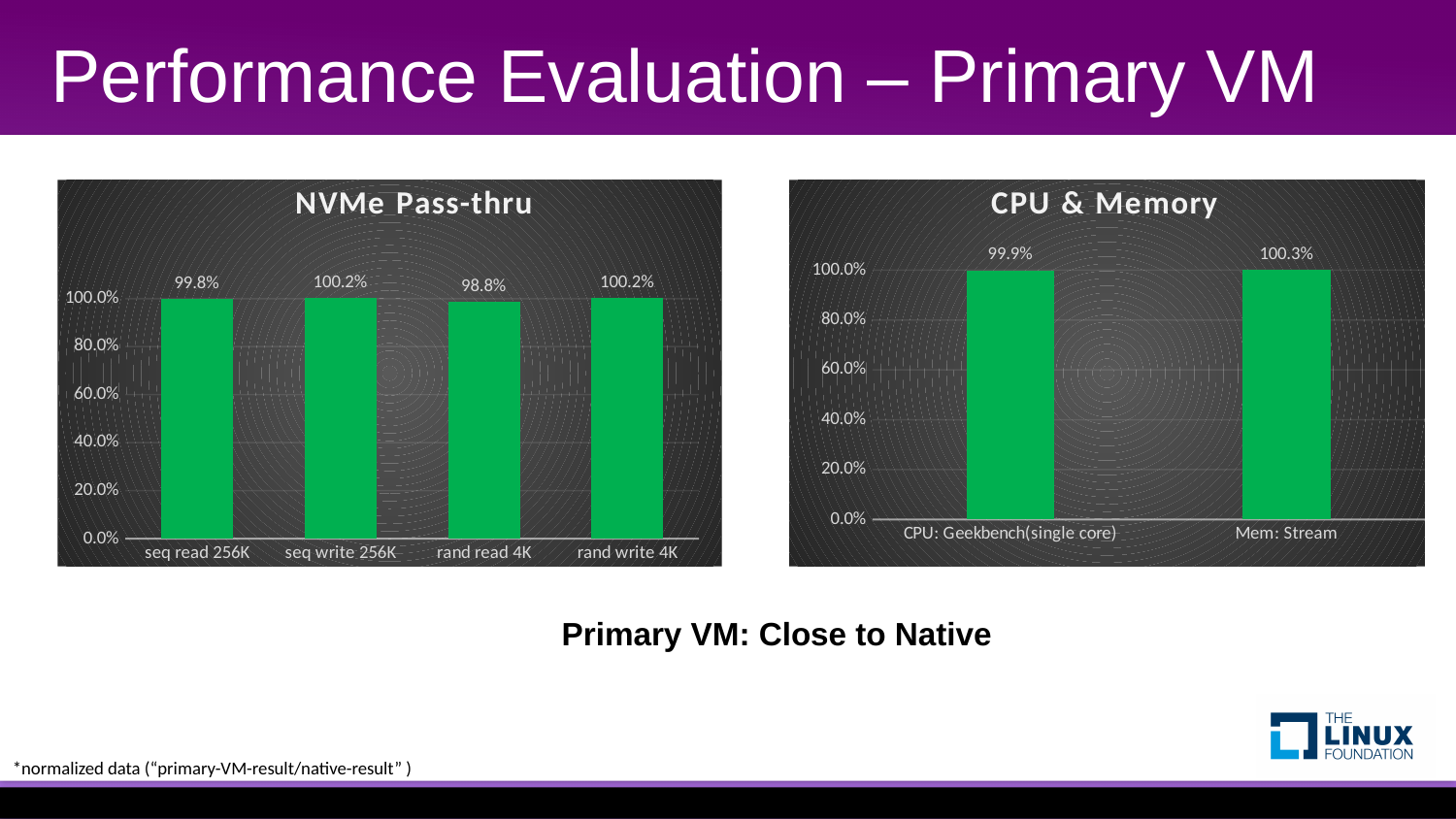
In the NVMe Pass-thru chart, what is the value for seq read 256K? 99.8% What is the title of the chart on the left side of the slide? NVMe Pass-thru In the CPU & Memory chart, which category has the higher value? Mem: Stream In the CPU & Memory chart, what is the value for Mem: Stream? 100.3% In the NVMe Pass-thru chart, what is the difference between seq write 256K and rand read 4K? 1.4% In the CPU & Memory chart, what is the value for CPU: Geekbench(single core)? 99.9% In the NVMe Pass-thru chart, how many categories are shown? 4 In the CPU & Memory chart, what is the difference between Mem: Stream and CPU: Geekbench(single core)? 0.4% In the NVMe Pass-thru chart, is the value for seq read 256K greater or less than 80.0%? greater In the NVMe Pass-thru chart, what is the value for rand read 4K? 98.8% What type of chart is the CPU & Memory chart? Bar chart In the NVMe Pass-thru chart, which category has the lowest value? rand read 4K